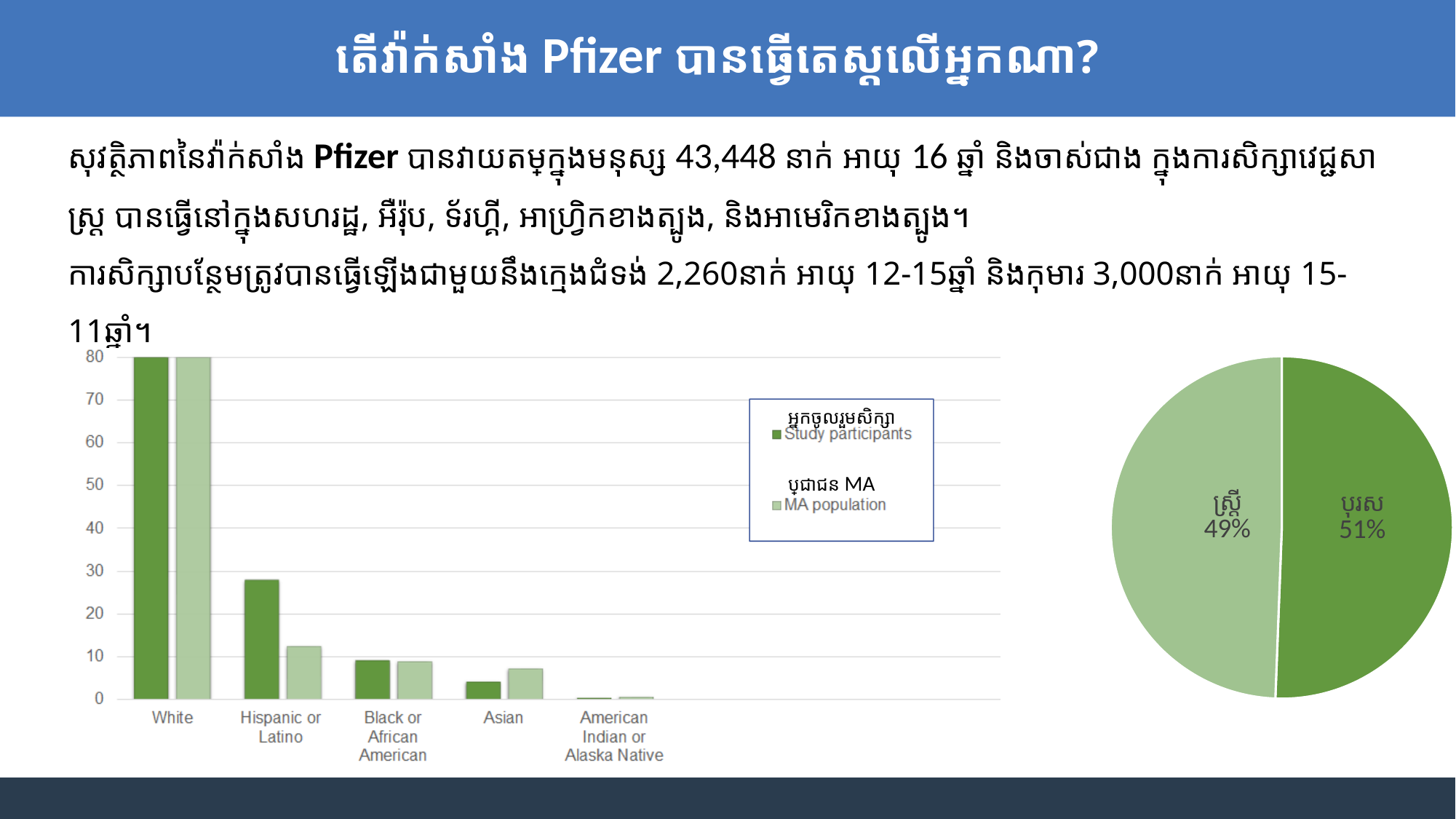
In the bar chart on the left, is the Study participants value for Hispanic or Latino greater or less than 20? greater In the bar chart on the left, for Asian, which series has the larger value: Study participants or MA population? MA population In the pie chart on the right, what share is labelled for បុរស? 51% In the pie chart on the right, which slice is larger: ស្ត្រី or បុរស? បុរស In the pie chart on the right, what is the difference between the បុរស share and the ស្ត្រី share? 2% What kind of chart is the chart on the right of the slide? pie chart In the bar chart on the left, how many series does the legend list? 2 In the bar chart on the left, which category has the lowest value for MA population? American Indian or Alaska Native In the bar chart on the left, how many categories are shown on the x axis? 5 What kind of chart is the chart on the left of the slide? bar chart In the bar chart on the left, which category has the highest value for Study participants? White In the bar chart on the left, is the MA population value for Hispanic or Latino greater or less than 20? less